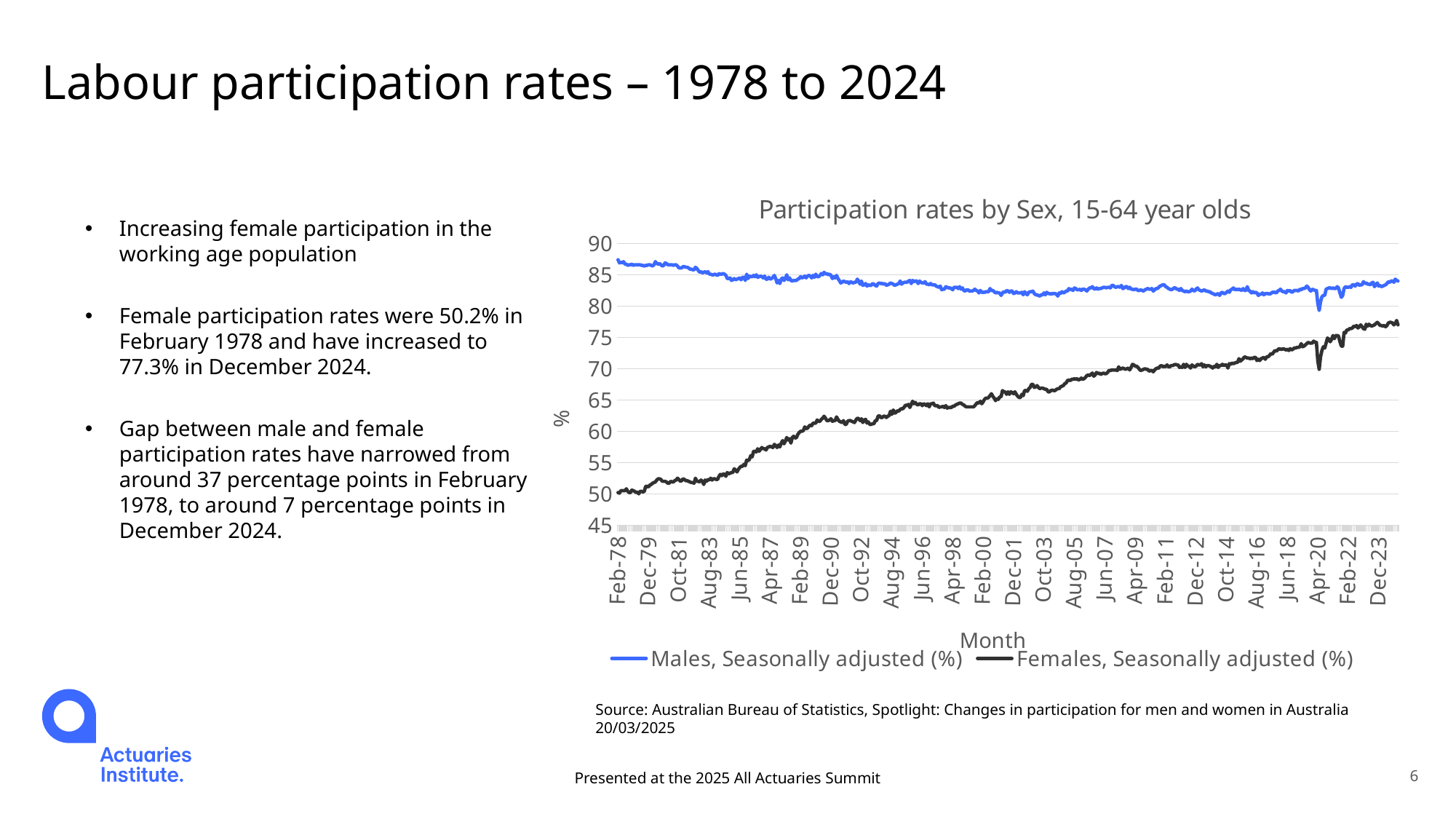
Does the male participation rate rise or fall overall from Feb-78 to Dec-23? Fall Is the value for Males, Seasonally adjusted (%) in Dec-23 greater or less than 80? greater How many series does the chart's legend list? 2 Is the value for Males, Seasonally adjusted (%) in Feb-78 greater or less than 85? greater According to the slide, what was the female participation rate in December 2024? 77.3% What is the title of the chart? Participation rates by Sex, 15-64 year olds Is the value for Females, Seasonally adjusted (%) in Feb-78 greater or less than 55? less What is the label on the x axis of the chart? Month Which series has the higher participation rate in Feb-78, Males or Females? Males Does the female participation rate rise or fall from Feb-78 to Dec-23? Rise What kind of chart is shown on the slide? Line chart